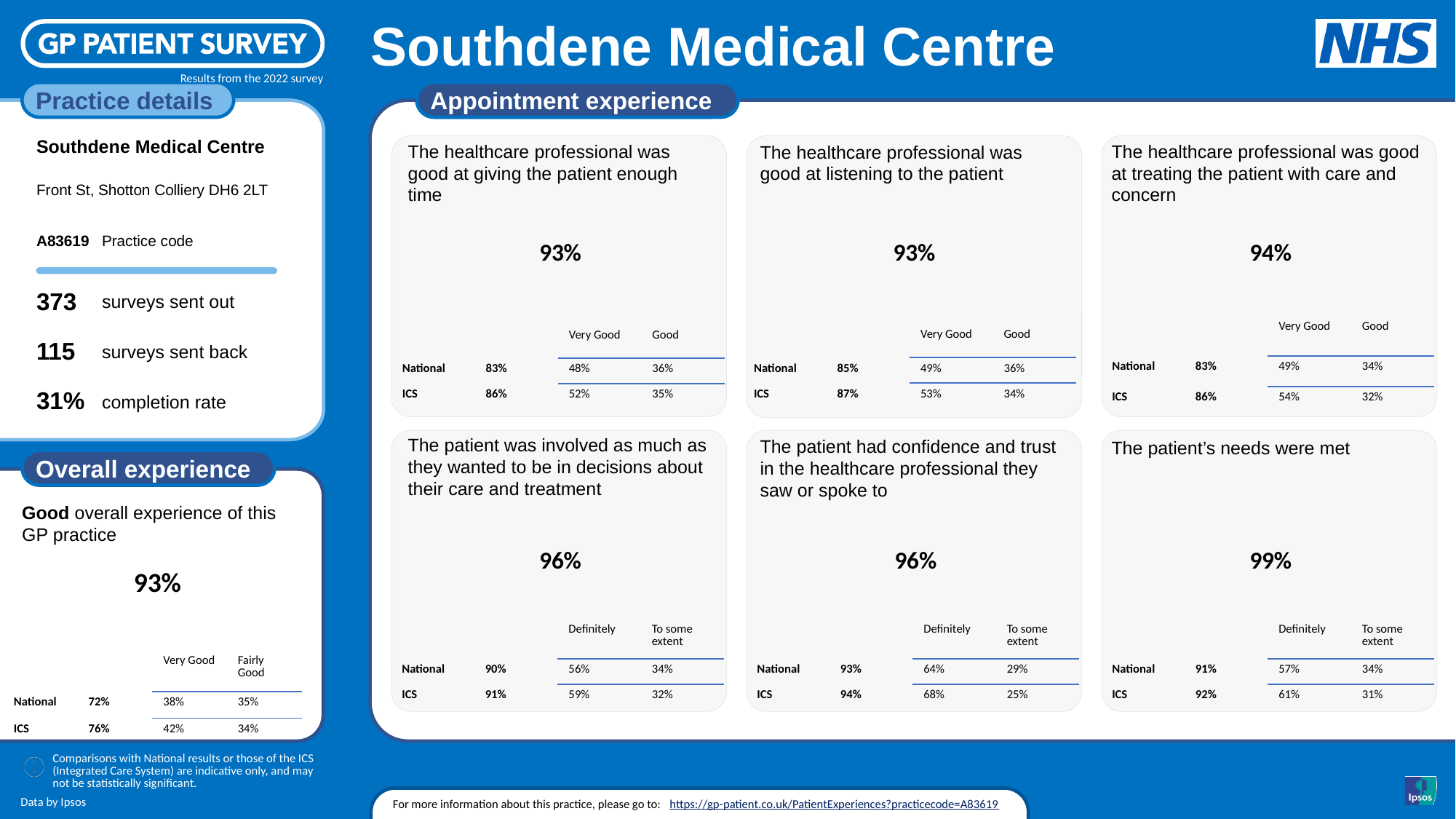
In the panel 'The patient was involved as much as they wanted to be in decisions about their care and treatment', what is the difference between the practice's 96% and the National 90%? 6% In the 'Overall experience' panel, what is the ICS 'Very Good' percentage? 42% In the 'Appointment experience' section, what is the ICS figure for 'The healthcare professional was good at listening to the patient'? 87% In the 'Overall experience' panel, what is the difference between the practice's 93% and the National 72%? 21% How many measures are shown in the 'Appointment experience' section? 6 In the 'Overall experience' panel, what is the National figure for good overall experience? 72% In the panel 'The patient's needs were met', what is the ICS 'To some extent' percentage? 31% In the panel 'The healthcare professional was good at treating the patient with care and concern', what is the National 'Very Good' percentage? 49% In the 'Appointment experience' section, which of the six measures has the highest practice percentage? The patient's needs were met In the 'Appointment experience' section, what percentage is shown for 'The patient's needs were met'? 99% In the 'Overall experience' panel, what percentage of patients reported a good overall experience of this GP practice? 93% In the panel 'The patient had confidence and trust in the healthcare professional they saw or spoke to', which is larger: the National figure or the ICS figure? ICS